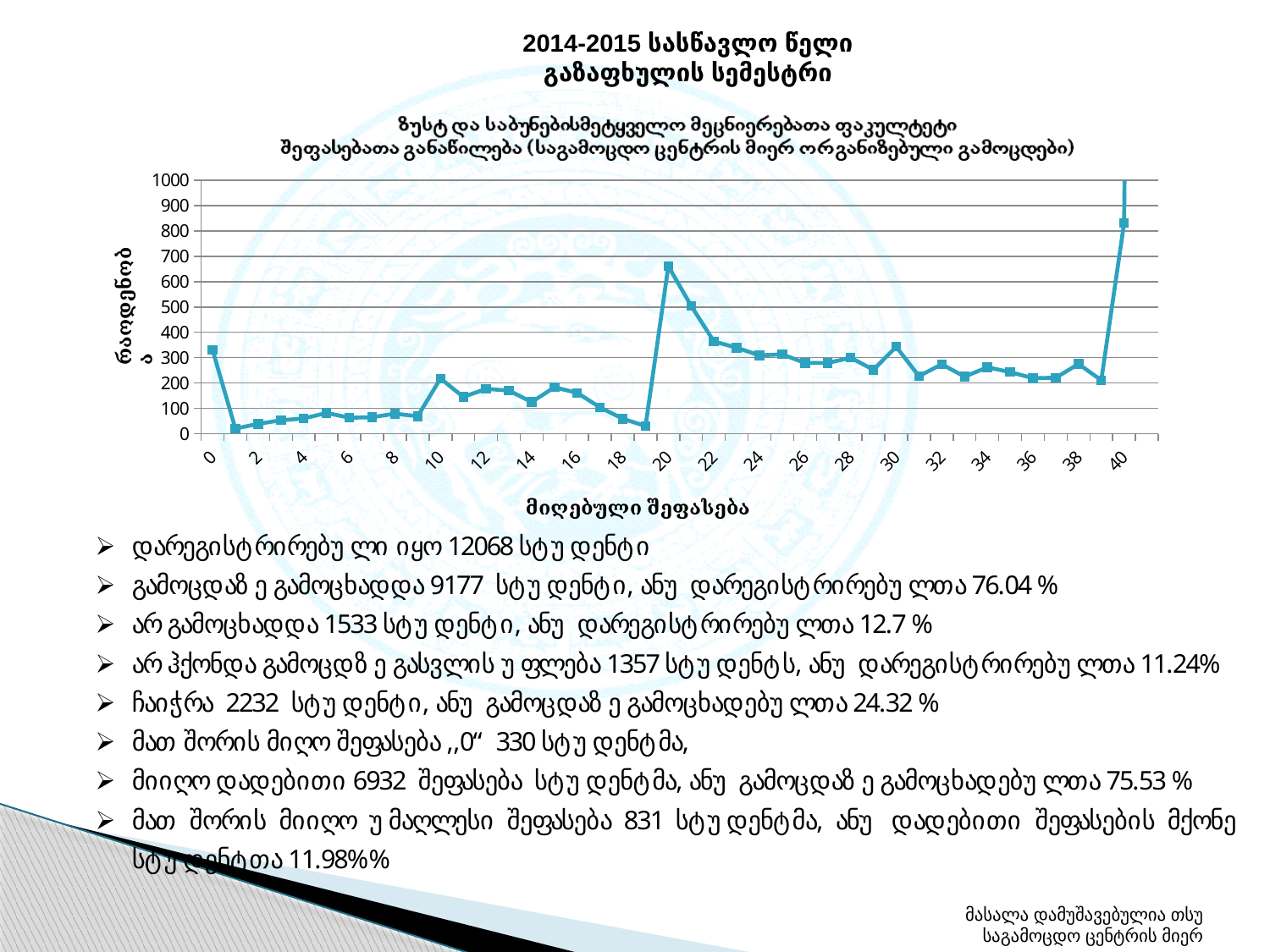
Is the value at x = 1 greater or less than 100? less Is the value at x = 19 greater or less than 100? less Is the value at x = 10 greater or less than 300? less Which is larger, the value at x = 20 or the value at x = 30? x = 20 Between x = 20 and x = 39, do the values generally rise or fall? fall Which is larger, the value at x = 0 or the value at x = 10? x = 0 What kind of chart is shown on the slide? line chart What is the label of the x axis? მიღებული შეფასება